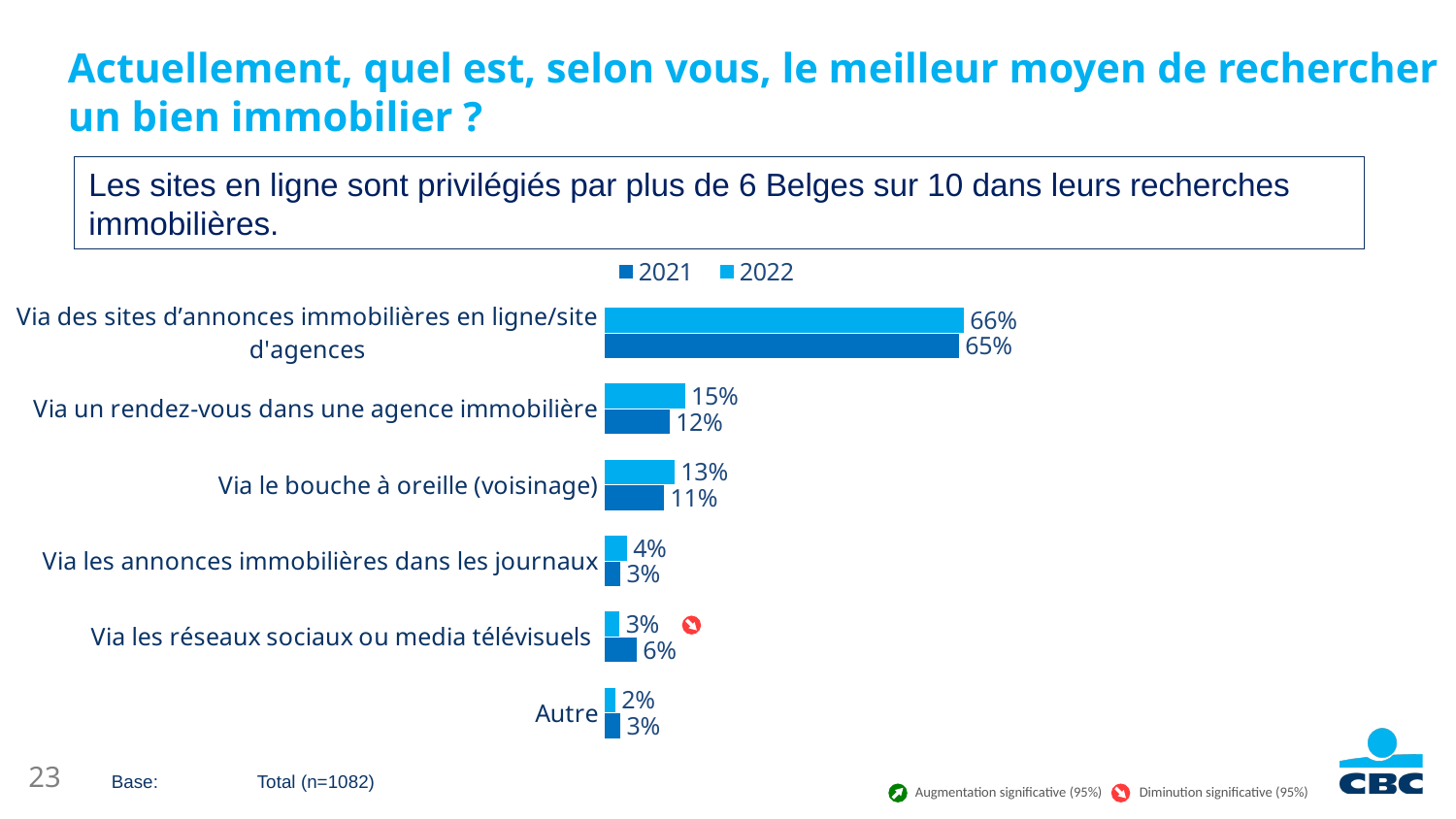
What is the 2022 value for "Via des sites d’annonces immobilières en ligne/site d'agences"? 66% For "Via les réseaux sociaux ou media télévisuels", which year has the larger value, 2021 or 2022? 2021 What is the 2022 value for "Via le bouche à oreille (voisinage)"? 13% What is the 2021 value for "Via les réseaux sociaux ou media télévisuels"? 6% Which category has the highest 2022 value? Via des sites d’annonces immobilières en ligne/site d'agences What is the 2021 value for "Via un rendez-vous dans une agence immobilière"? 12% What is the difference between the 2022 and 2021 values for "Via un rendez-vous dans une agence immobilière"? 3% How many categories are shown in the chart? 6 Which category has the lowest 2022 value? Autre Which series is shown in the lighter blue colour in the legend? 2022 What kind of chart is shown on the slide? bar chart How many series does the legend list? 2